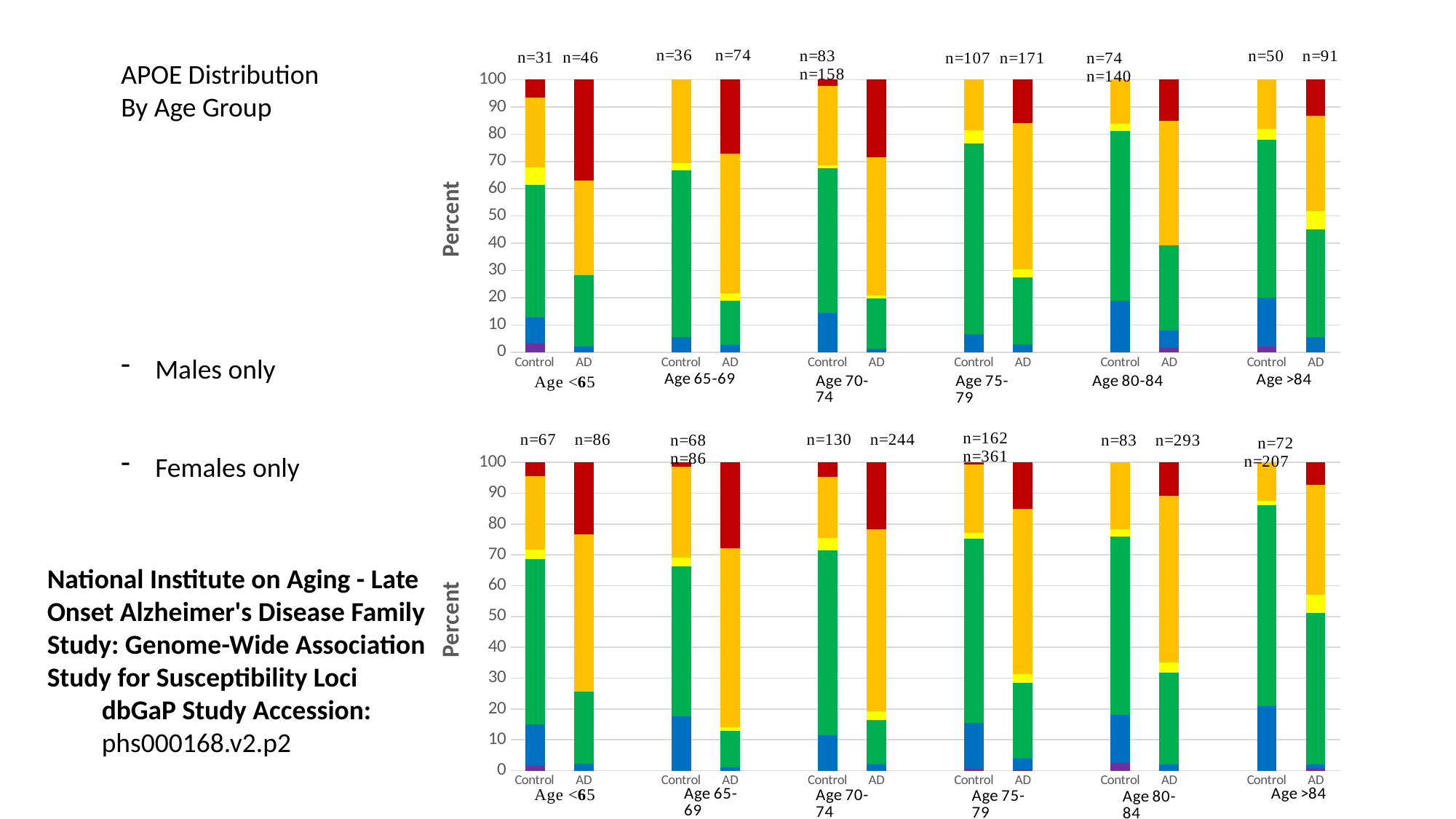
In the Males only chart, is the red segment of the Age <65 AD bar greater or less than 30 percentage points tall? greater What is the label on the y axis of both charts? Percent How many age groups are shown along the x axis of the Females only chart? 6 In the Males only chart for Age <65, which bar has the larger red segment, Control or AD? AD In the Females only chart, what is the n value printed above the Control bar for Age 70-74? n=130 In the Females only chart, is the top of the green segment for the Age >84 Control bar greater or less than 80? greater In the Females only chart, what is the n value printed above the AD bar for Age 80-84? n=293 In the Males only chart, is the top of the green segment for the Age 75-79 Control bar greater or less than 70? greater In the Males only chart, what is the n value printed above the AD bar for Age 75-79? n=171 What kind of chart is the top chart (Males only)? stacked bar chart How many bars are plotted in the Males only chart? 12 In the Females only chart for Age 65-69, which bar has the larger orange segment, Control or AD? AD